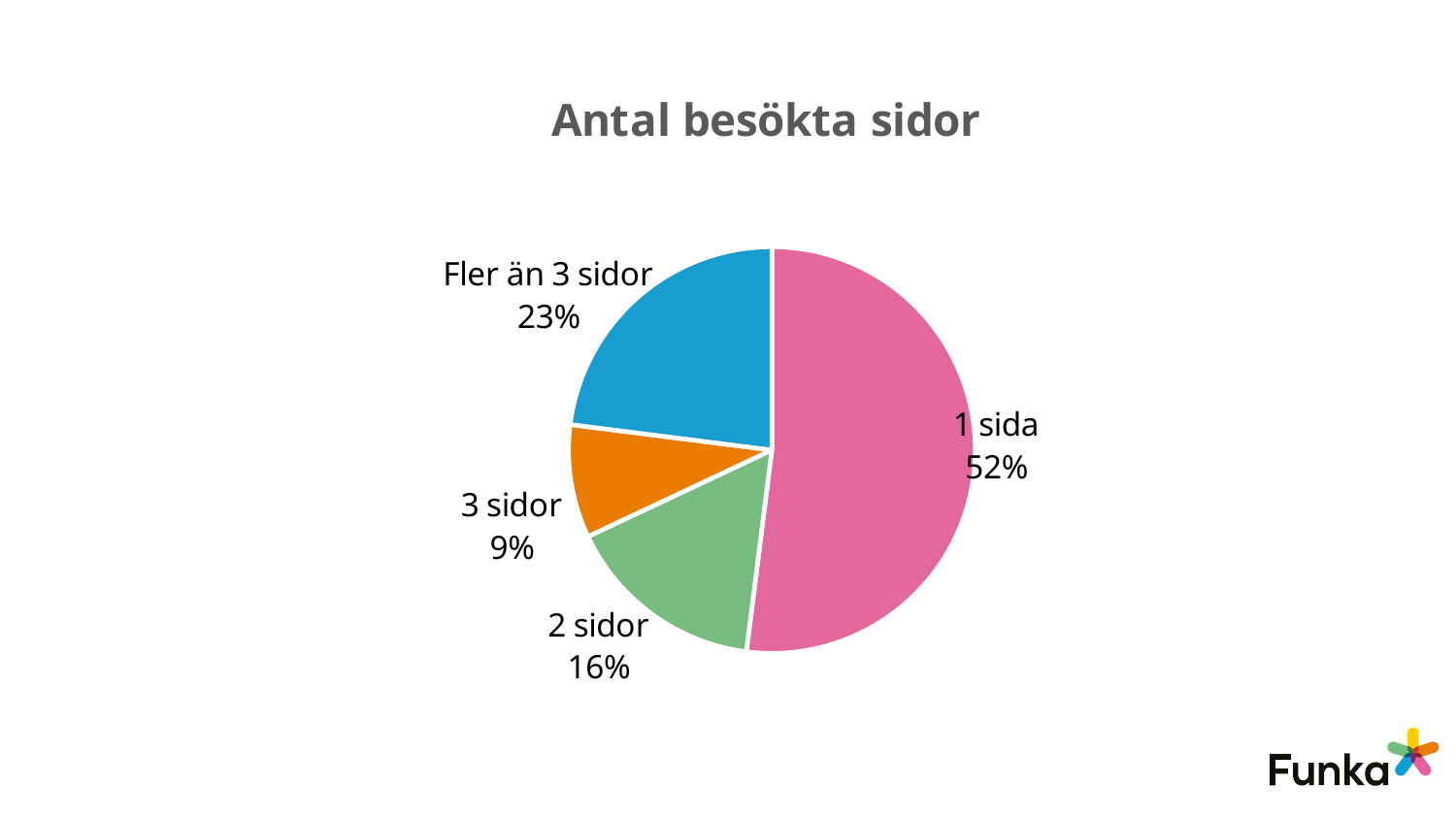
What is the value shown for "Fler än 3 sidor"? 23% How many slices does the pie chart have? 4 What is the difference in percentage points between "1 sida" and "Fler än 3 sidor"? 29 Which is larger, the slice for "2 sidor" or the slice for "Fler än 3 sidor"? Fler än 3 sidor What colour is the slice for "3 sidor"? Orange What is the title of the chart? Antal besökta sidor What kind of chart is shown on the slide? Pie chart Which category has the smallest slice? 3 sidor What is the value shown for "2 sidor"? 16% What share of the pie does "1 sida" have? 52% What is the value shown for "3 sidor"? 9% Which category has the largest slice? 1 sida